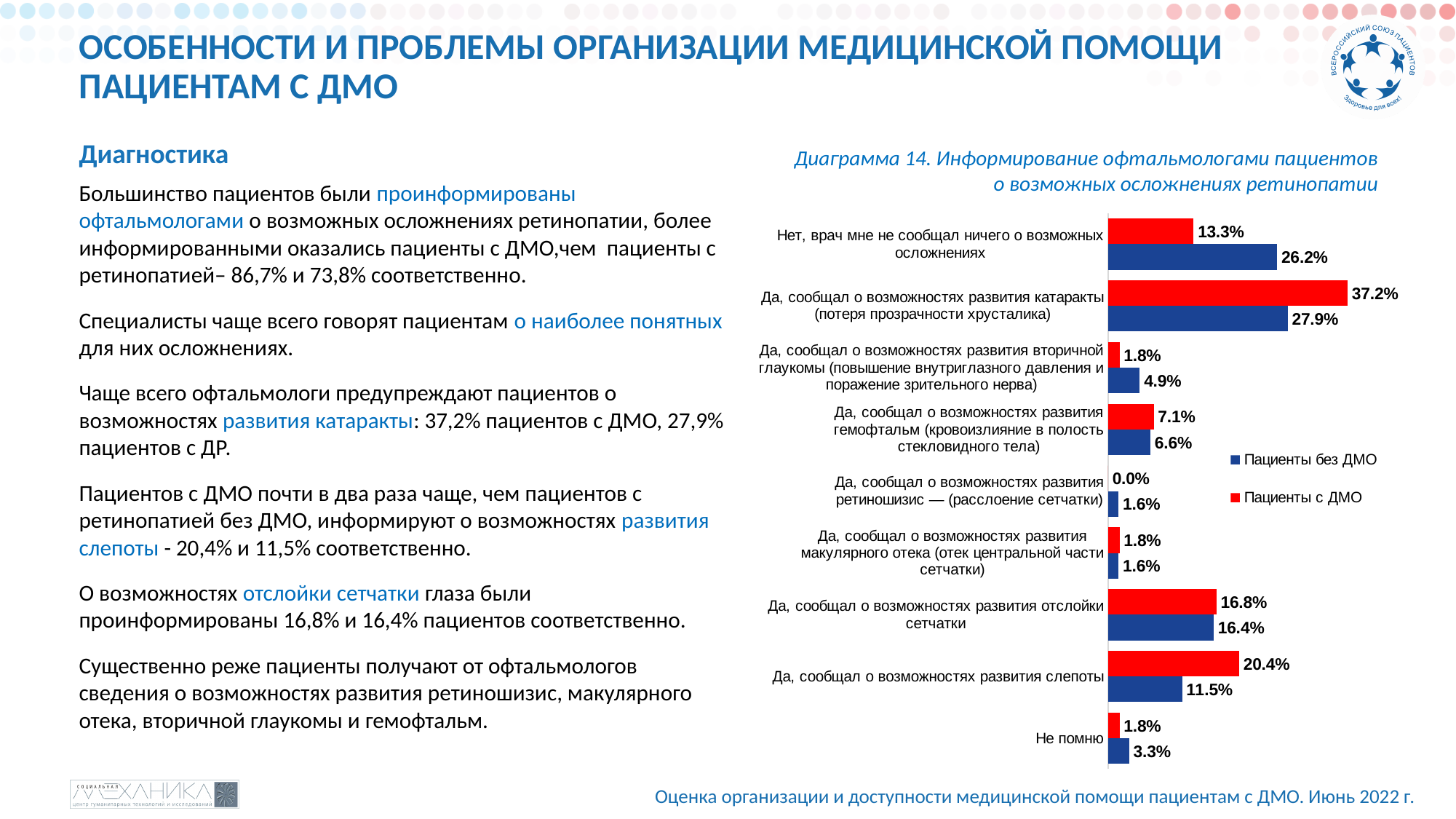
Какое значение показано для пациентов с ДМО по категории «Да, сообщал о возможностях развития слепоты»? 20.4% На сколько процентных пунктов значение для пациентов с ДМО по категории «развития слепоты» больше, чем для пациентов без ДМО? 8.9 Каким цветом на диаграмме обозначены пациенты с ДМО? Красным Какой процент пациентов с ДМО сообщили, что врач информировал их о возможностях развития катаракты? 37.2% Сколько категорий ответов показано на диаграмме? 9 По какой категории значение для пациентов с ДМО самое низкое? Да, сообщал о возможностях развития ретиношизис — (расслоение сетчатки) Какого типа эта диаграмма? Столбчатая (bar chart) По какой категории значение для пациентов с ДМО самое высокое? Да, сообщал о возможностях развития катаракты (потеря прозрачности хрусталика) Какое значение показано для пациентов без ДМО по категории «Не помню»? 3.3% Какой процент пациентов без ДМО ответили «Нет, врач мне не сообщал ничего о возможных осложнениях»? 26.2% Какая группа имеет большее значение по категории «Да, сообщал о возможностях развития вторичной глаукомы»: пациенты с ДМО или без ДМО? Пациенты без ДМО Сколько серий указано в легенде диаграммы? 2